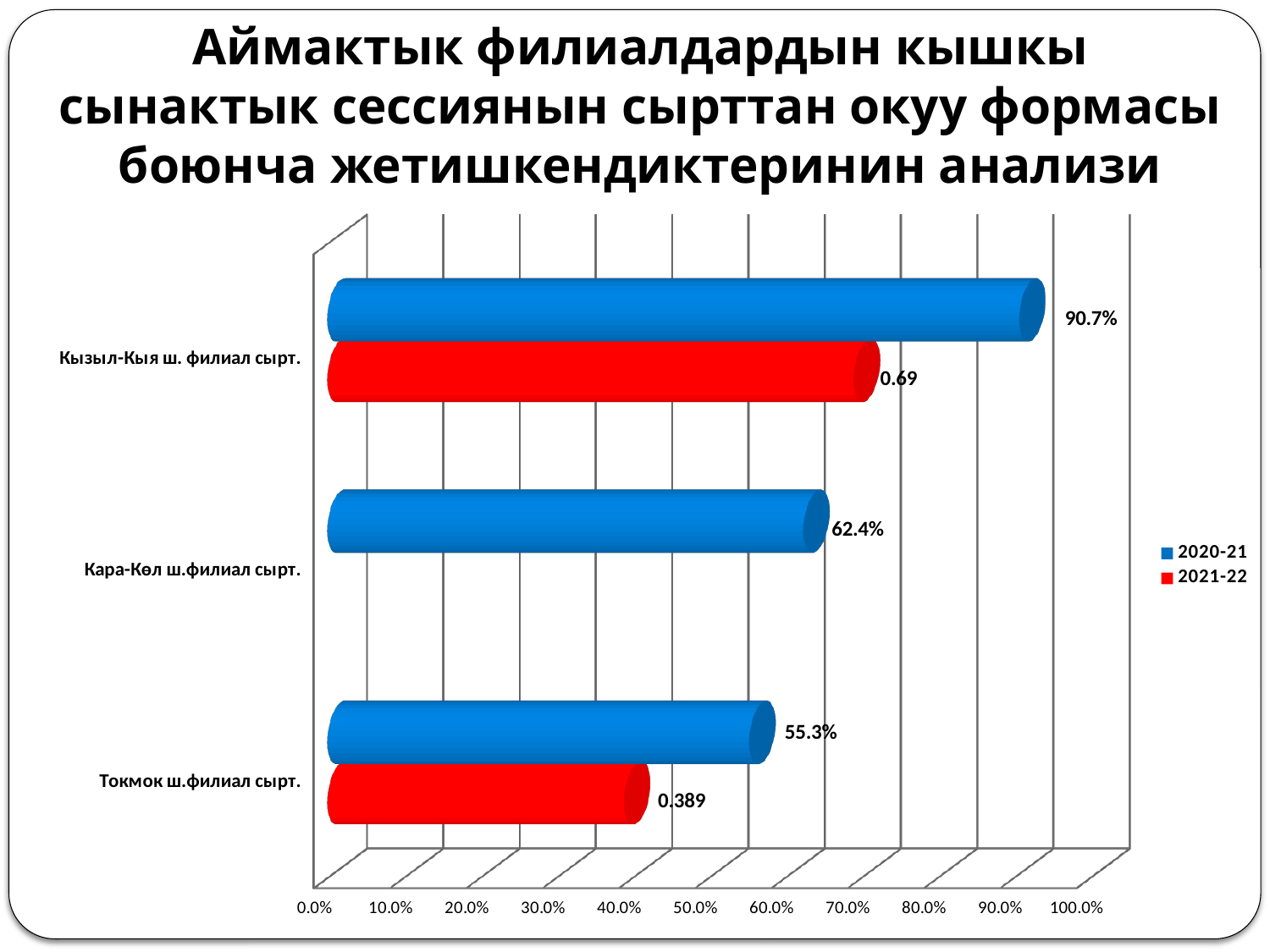
What is the 2020-21 value for Кара-Көл ш.филиал сырт.? 62.4% How many series does the legend list? 2 What is the 2021-22 value for Токмок ш.филиал сырт.? 0.389 Which is larger: the 2021-22 value for Кызыл-Кыя ш. филиал сырт. or the 2021-22 value for Токмок ш.филиал сырт.? Кызыл-Кыя ш. филиал сырт. Which category has the lowest 2020-21 value? Токмок ш.филиал сырт. What is the difference between the 2020-21 values for Кара-Көл ш.филиал сырт. and Токмок ш.филиал сырт.? 7.1 percentage points What is the 2020-21 value for Кызыл-Кыя ш. филиал сырт.? 90.7% What is the 2021-22 value for Кызыл-Кыя ш. филиал сырт.? 0.69 How many categories are shown on the chart? 3 Which category has the highest 2020-21 value? Кызыл-Кыя ш. филиал сырт. What is the difference between the 2020-21 values for Кызыл-Кыя ш. филиал сырт. and Кара-Көл ш.филиал сырт.? 28.3 percentage points What kind of chart is shown on the slide? Bar chart